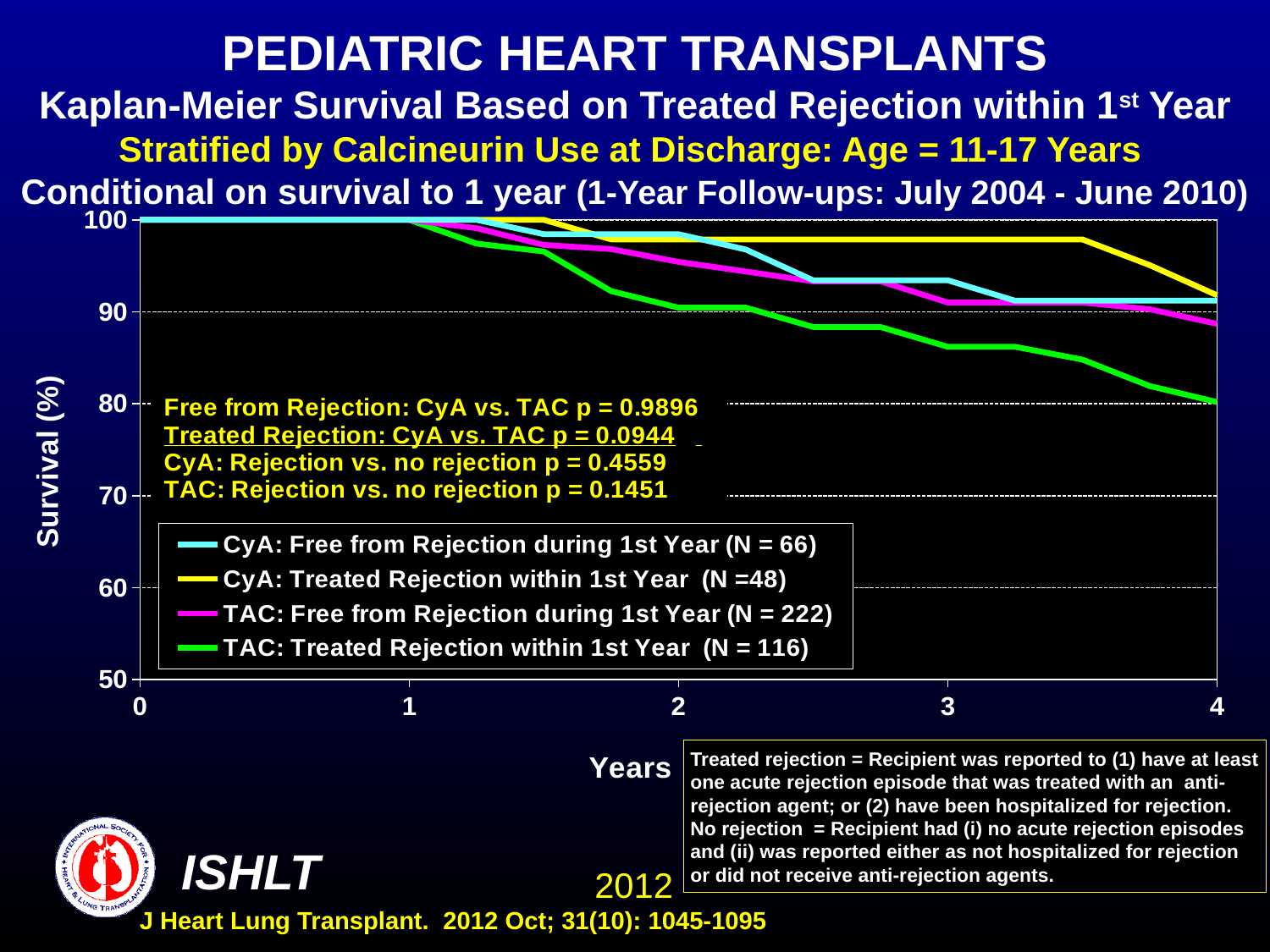
What is the p-value for Treated Rejection: CyA vs. TAC? 0.0944 Which group has the lowest survival at 4 years? TAC: Treated Rejection within 1st Year What is the label of the y axis? Survival (%) What is the p-value for TAC: Rejection vs. no rejection? 0.1451 What is the N for the 'TAC: Free from Rejection during 1st Year' group? 222 What kind of chart is shown on the slide? Line chart What is the N for the 'CyA: Treated Rejection within 1st Year' group? 48 Do the survival curves rise or fall as years increase? Fall Is the survival for the CyA: Treated Rejection within 1st Year group at 3 years greater or less than 90? greater What is the N for the 'TAC: Treated Rejection within 1st Year' group? 116 How many series does the legend list? 4 Is the survival for the TAC: Treated Rejection within 1st Year group at 3 years greater or less than 90? less